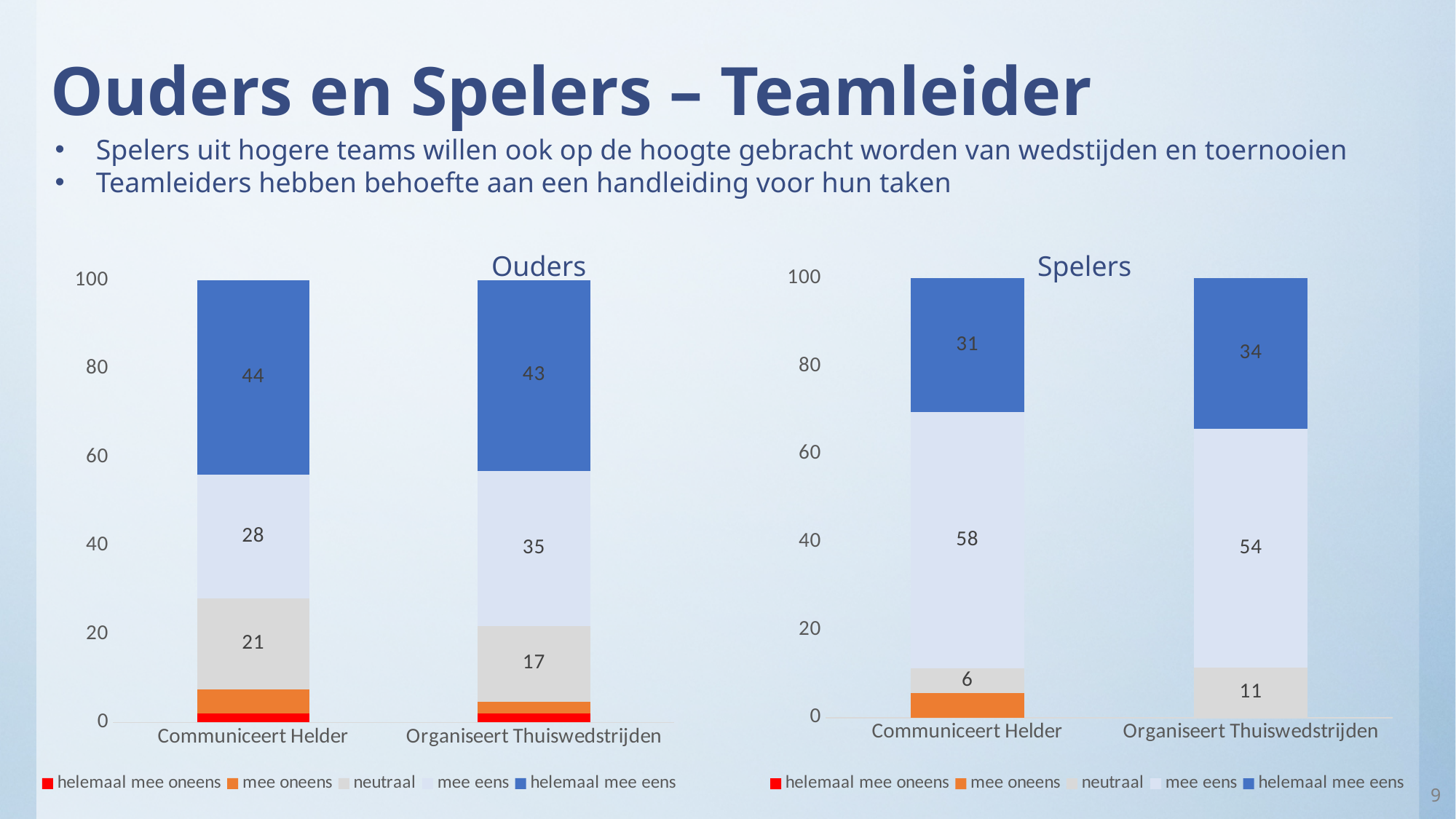
In the Ouders chart, what is the value for 'helemaal mee eens' for Communiceert Helder? 44 In the Spelers chart, what is the value for 'neutraal' for Organiseert Thuiswedstrijden? 11 In the Ouders chart, is the 'mee oneens' value for Communiceert Helder greater or less than 20? less What kind of chart is the Spelers chart? Stacked bar chart In the Spelers chart, which category has the larger 'helemaal mee eens' value, Communiceert Helder or Organiseert Thuiswedstrijden? Organiseert Thuiswedstrijden How many series does the legend of the Spelers chart list? 5 In the Spelers chart, what is the difference between the 'mee eens' values for Communiceert Helder and Organiseert Thuiswedstrijden? 4 In the Spelers chart, what is the value for 'mee eens' for Communiceert Helder? 58 In the Ouders chart, which category has the larger 'neutraal' value, Communiceert Helder or Organiseert Thuiswedstrijden? Communiceert Helder How many categories are shown on the x axis of the Ouders chart? 2 In the Ouders chart, what is the difference between the 'mee eens' values for Organiseert Thuiswedstrijden and Communiceert Helder? 7 In the Ouders chart, what is the value for 'mee eens' for Organiseert Thuiswedstrijden? 35